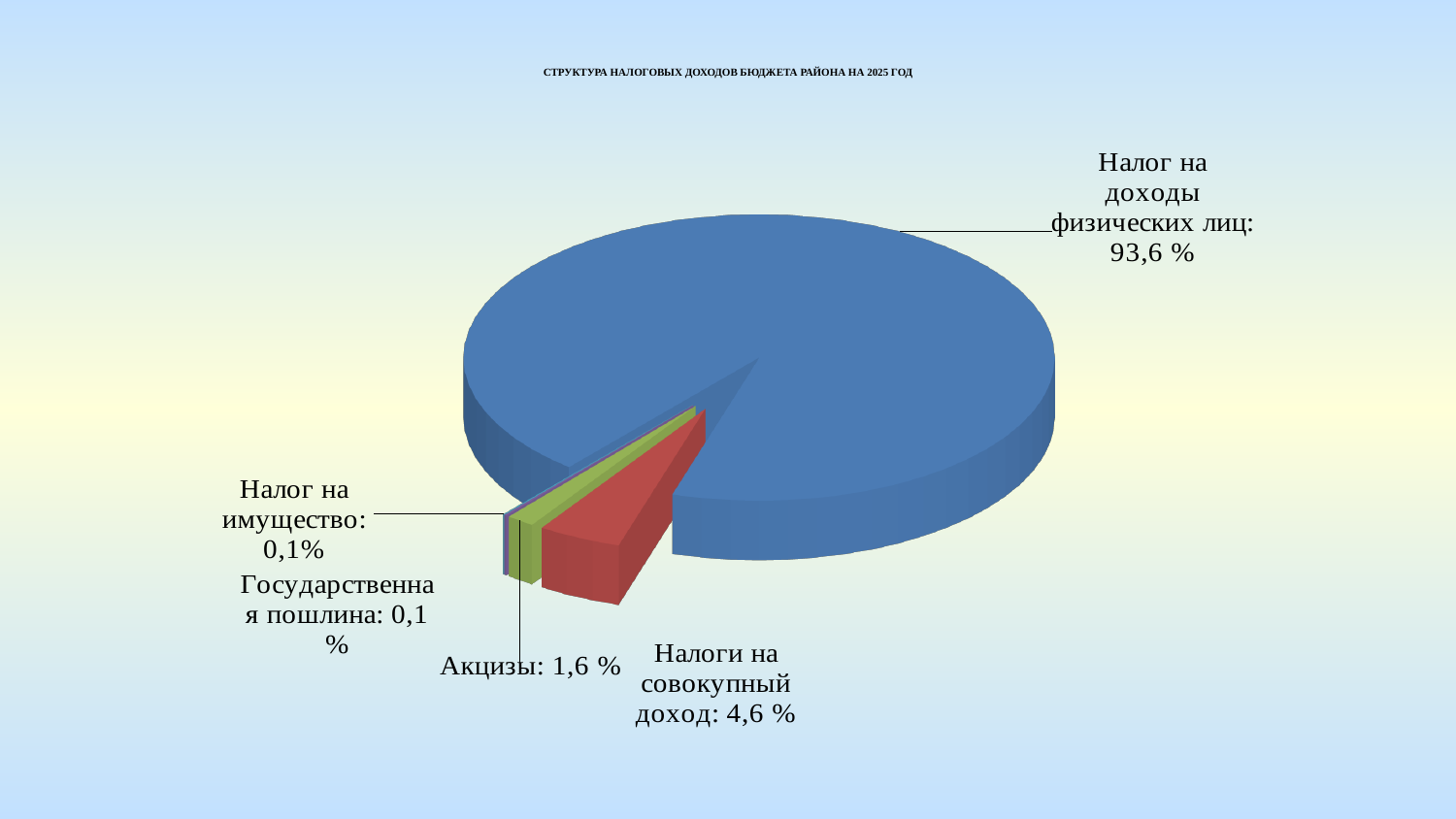
How many categories are shown in the pie chart? 5 What value is shown for "Налог на имущество"? 0,1% What is the difference between the shares of "Налоги на совокупный доход" and "Акцизы"? 3,0 percentage points What value is shown for "Налоги на совокупный доход"? 4,6 % Which category has the largest slice of the pie? Налог на доходы физических лиц What type of chart is shown on the slide? Pie chart What is the title of the chart? СТРУКТУРА НАЛОГОВЫХ ДОХОДОВ БЮДЖЕТА РАЙОНА НА 2025 ГОД What value is shown for "Государственная пошлина"? 0,1 % What share of the pie does "Налог на доходы физических лиц" have? 93,6 % What is the difference between the shares of "Налог на доходы физических лиц" and "Налоги на совокупный доход"? 89,0 percentage points What value is shown for "Акцизы"? 1,6 % Which is larger, the share of "Акцизы" or the share of "Налоги на совокупный доход"? Налоги на совокупный доход